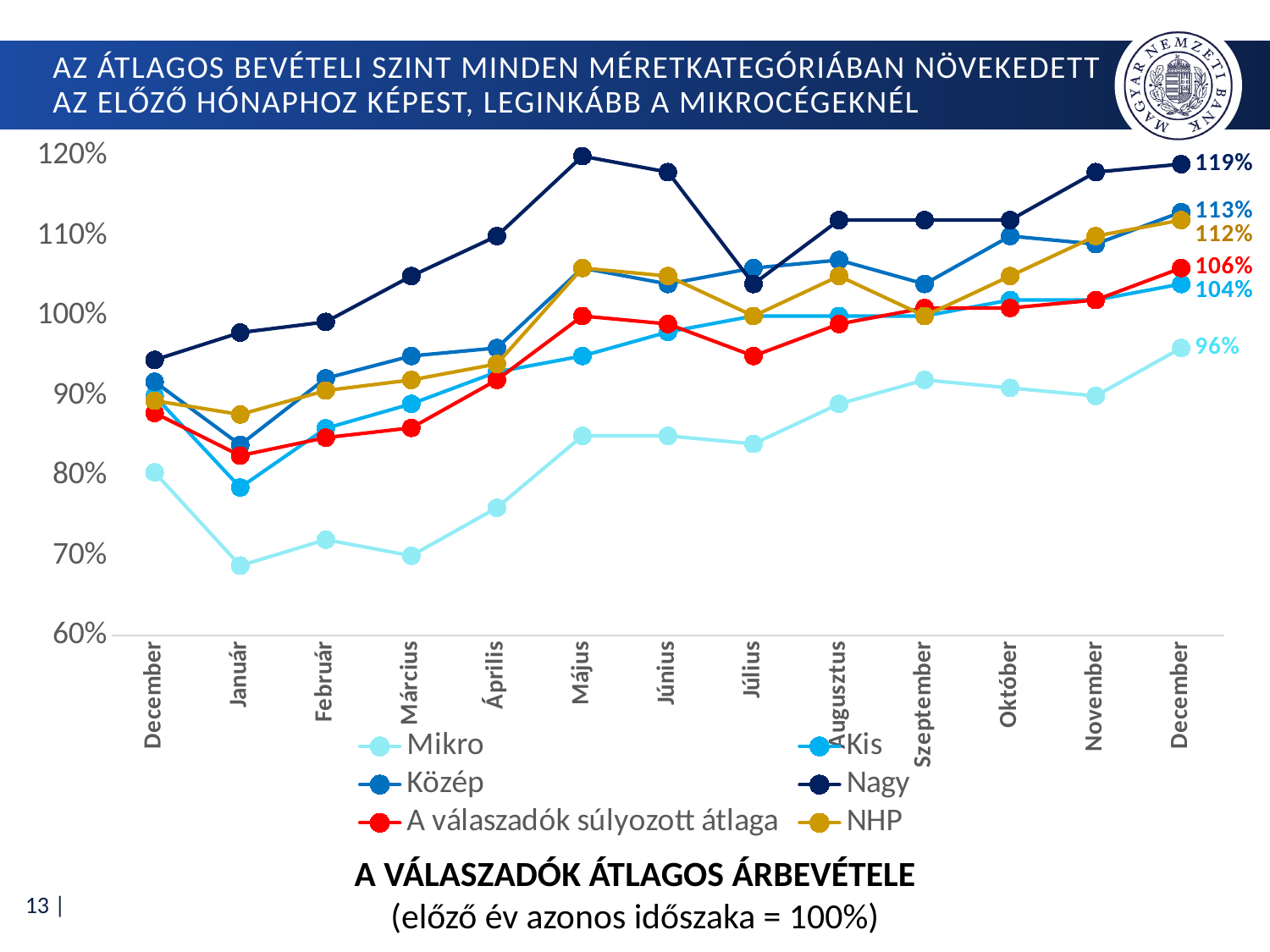
How many series does the legend list? 6 Which series has the lowest value at the final December? Mikro Is the value of the Mikro series in Január greater or less than 70%? less Does the Mikro series generally rise or fall from the first December to the last December? rise What kind of chart is shown on the slide? line chart How many points are plotted along the x axis for each series? 13 Which series has the highest value at the final December? Nagy What is the value of the Nagy series at the final December? 119% What is the value of the Mikro series at the final December? 96% What is the value of the NHP series at the final December? 112% What is the value of the Kis series at the final December? 104% What is the difference between the Nagy and Mikro values at the final December? 23 percentage points